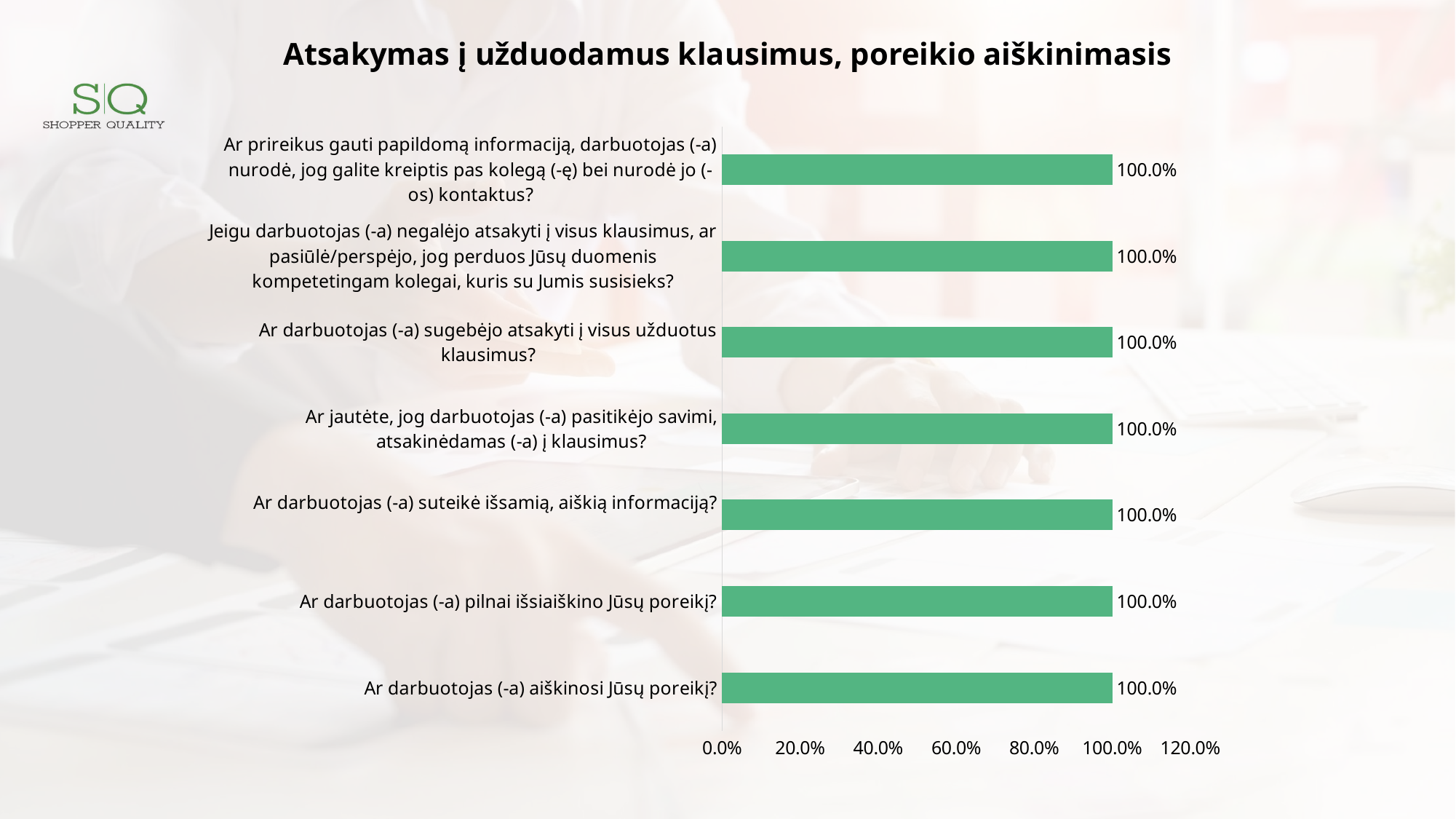
What is the value for "Ar jautėte, jog darbuotojas (-a) pasitikėjo savimi, atsakinėdamas (-a) į klausimus?"? 100.0% What is the title of the chart? Atsakymas į užduodamus klausimus, poreikio aiškinimasis Is the value for "Ar darbuotojas (-a) suteikė išsamią, aiškią informaciją?" greater or less than 80.0%? greater What is the value for "Ar darbuotojas (-a) pilnai išsiaiškino Jūsų poreikį?"? 100.0% How many categories (questions) are plotted in the chart? 7 What is the highest value shown on the x axis? 120.0% What is the value for "Ar darbuotojas (-a) aiškinosi Jūsų poreikį?"? 100.0% What is the difference between the value for "Ar darbuotojas (-a) aiškinosi Jūsų poreikį?" and the value for "Ar darbuotojas (-a) pilnai išsiaiškino Jūsų poreikį?"? 0.0% What is the value for "Ar darbuotojas (-a) sugebėjo atsakyti į visus užduotus klausimus?"? 100.0% What is the value for "Ar darbuotojas (-a) suteikė išsamią, aiškią informaciją?"? 100.0% What type of chart is shown on the slide? bar chart